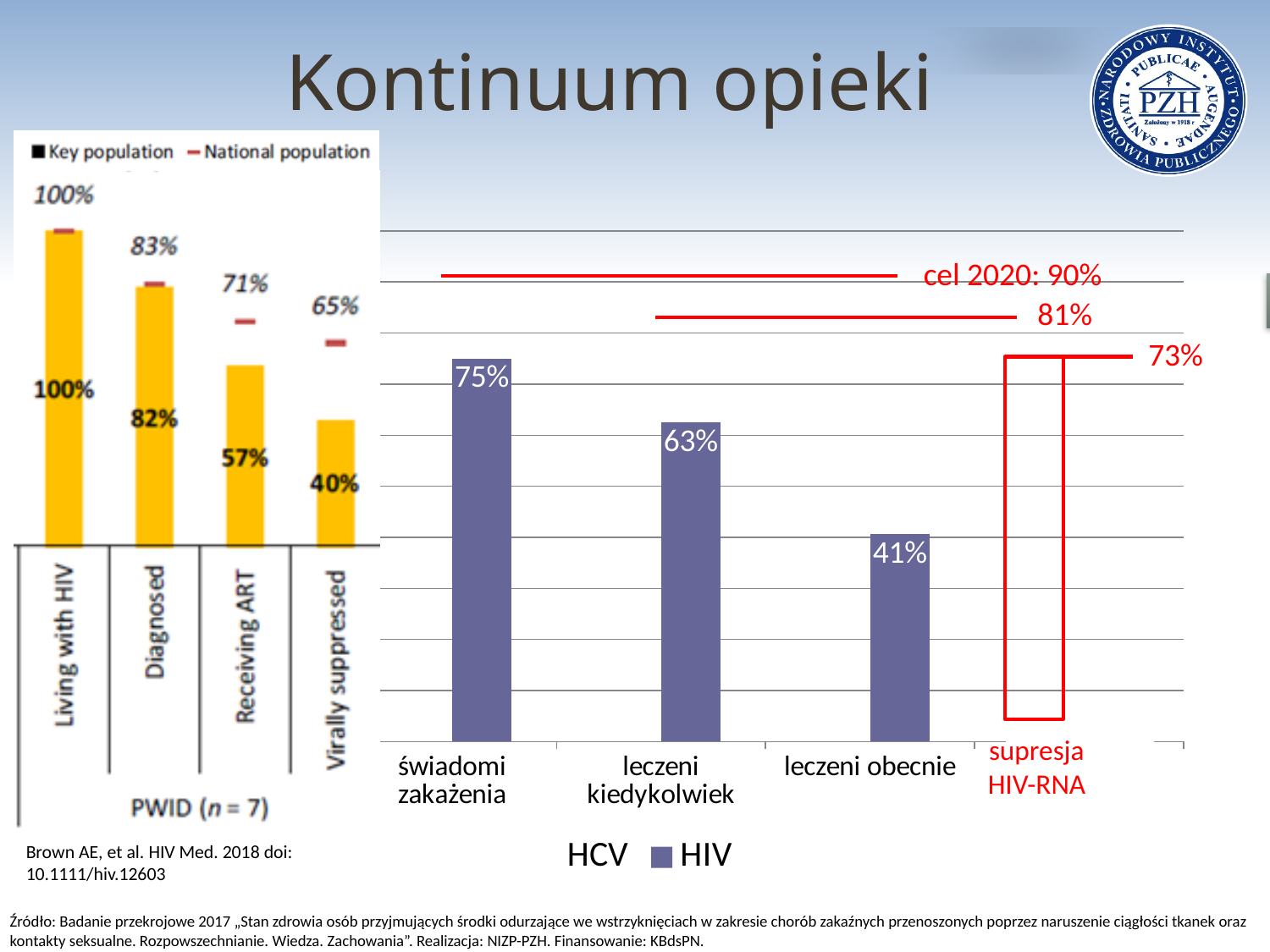
In the right-hand bar chart, what is the difference between the values for 'świadomi zakażenia' and 'leczeni obecnie'? 34% In the right-hand bar chart, what is the value for 'świadomi zakażenia'? 75% In the left-hand chart (PWID, n = 7), what is the Key population value for 'Receiving ART'? 57% In the right-hand bar chart, how many series does the legend list? 2 In the left-hand chart (PWID, n = 7), what is the National population value for 'Virally suppressed'? 65% In the right-hand bar chart, what target value is labelled 'cel 2020'? 90% In the right-hand bar chart, what is the value for 'leczeni kiedykolwiek'? 63% What kind of chart is the left-hand chart (PWID, n = 7)? bar chart In the right-hand bar chart, what is the value for 'leczeni obecnie'? 41% In the right-hand bar chart, which labelled category has the lowest value? leczeni obecnie In the right-hand bar chart, do the labelled bar values rise or fall from left to right? fall In the left-hand chart (PWID, n = 7), which is larger for 'Diagnosed': the Key population value or the National population value? National population